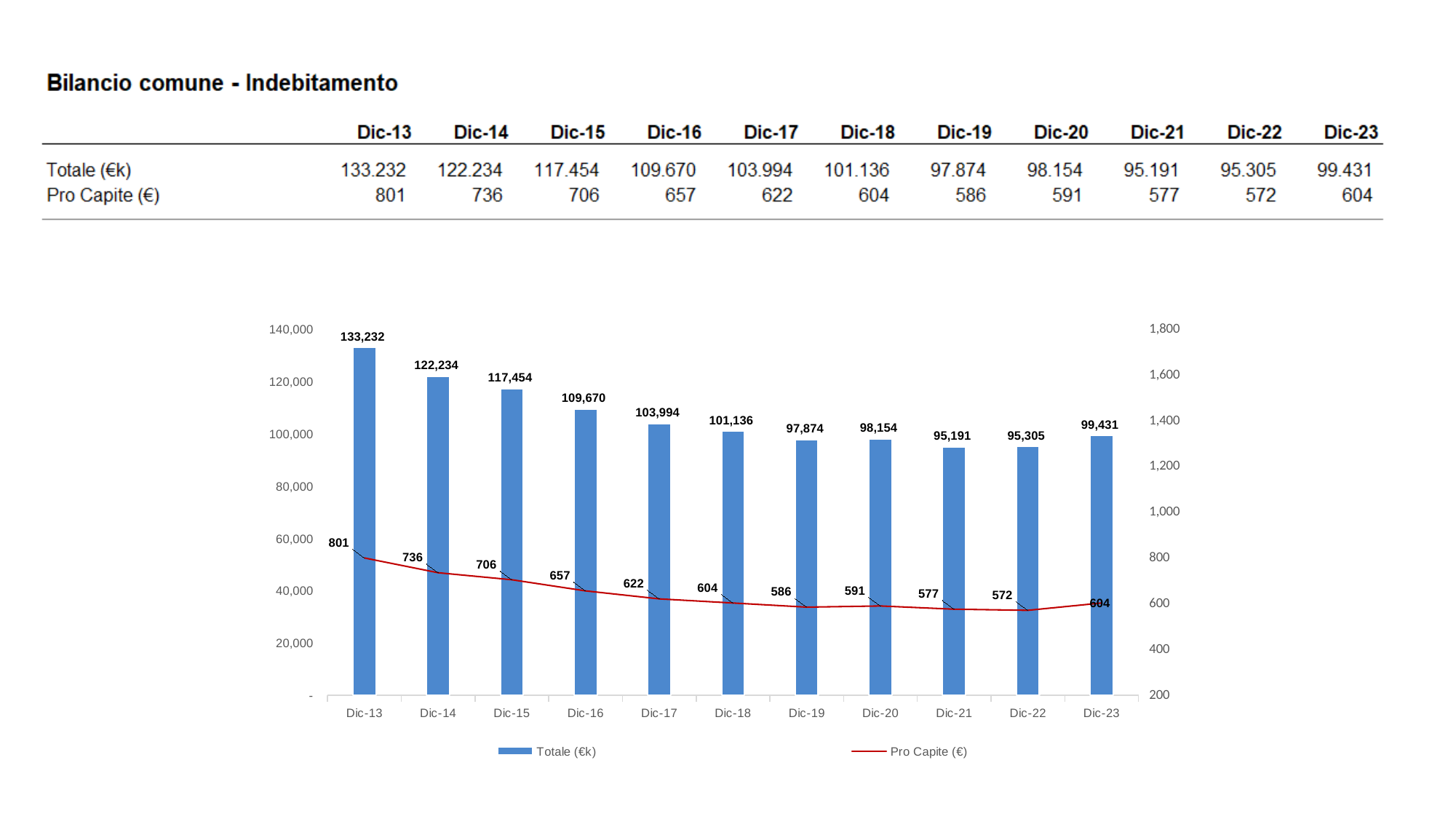
Does the Pro Capite (€) line generally rise or fall from Dic-13 to Dic-22? fall Which year has the lowest Pro Capite (€) value? Dic-22 Which year has the highest Totale (€k) value? Dic-13 What is the Totale (€k) value for Dic-13 in the chart? 133,232 How many series does the chart legend list? 2 What is the Totale (€k) value for Dic-23 in the chart? 99,431 What is the difference between the Totale (€k) values for Dic-13 and Dic-14? 10,998 What is the difference between the Pro Capite (€) values for Dic-22 and Dic-23? 32 What is the Pro Capite (€) value for Dic-19 in the chart? 586 What kind of chart is used to show the Totale (€k) series? bar chart How many years are shown on the x axis of the chart? 11 Which is larger, the Totale (€k) value for Dic-20 or for Dic-21? Dic-20